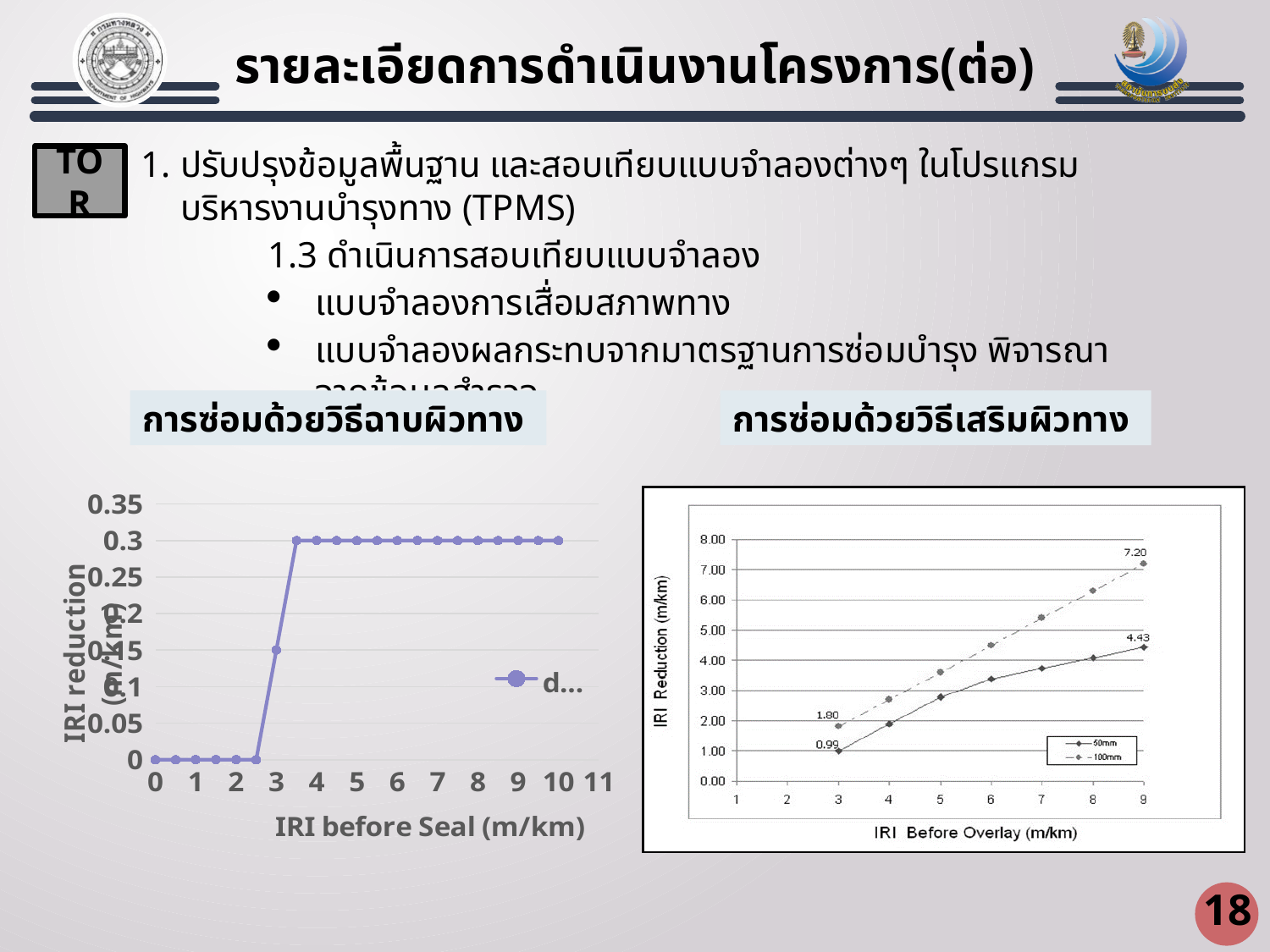
In the right chart (IRI Before Overlay), what is the IRI reduction for the 100mm series at IRI Before Overlay = 9? 7.20 In the left chart (IRI before Seal), is the IRI reduction value at IRI before Seal = 5 greater or less than 0.25? greater In the left chart (IRI before Seal), what is the IRI reduction value at IRI before Seal = 0? 0 In the right chart (IRI Before Overlay), is the 50mm value at IRI Before Overlay = 6 greater or less than 4.00? less What kind of chart is the left chart (IRI before Seal)? line chart In the right chart (IRI Before Overlay), which series has the larger value at IRI Before Overlay = 3, 50mm or 100mm? 100mm In the right chart (IRI Before Overlay), what is the difference between the 100mm and 50mm values at IRI Before Overlay = 9? 2.77 In the right chart (IRI Before Overlay), how many series does the legend list? 2 In the left chart (IRI before Seal), what is the IRI reduction value at IRI before Seal = 10? 0.3 In the right chart (IRI Before Overlay), what is the IRI reduction for the 50mm series at IRI Before Overlay = 3? 0.99 In the left chart (IRI before Seal), what is the IRI reduction value at IRI before Seal = 3? 0.15 In the left chart (IRI before Seal), do the values rise or fall as IRI before Seal increases? rise